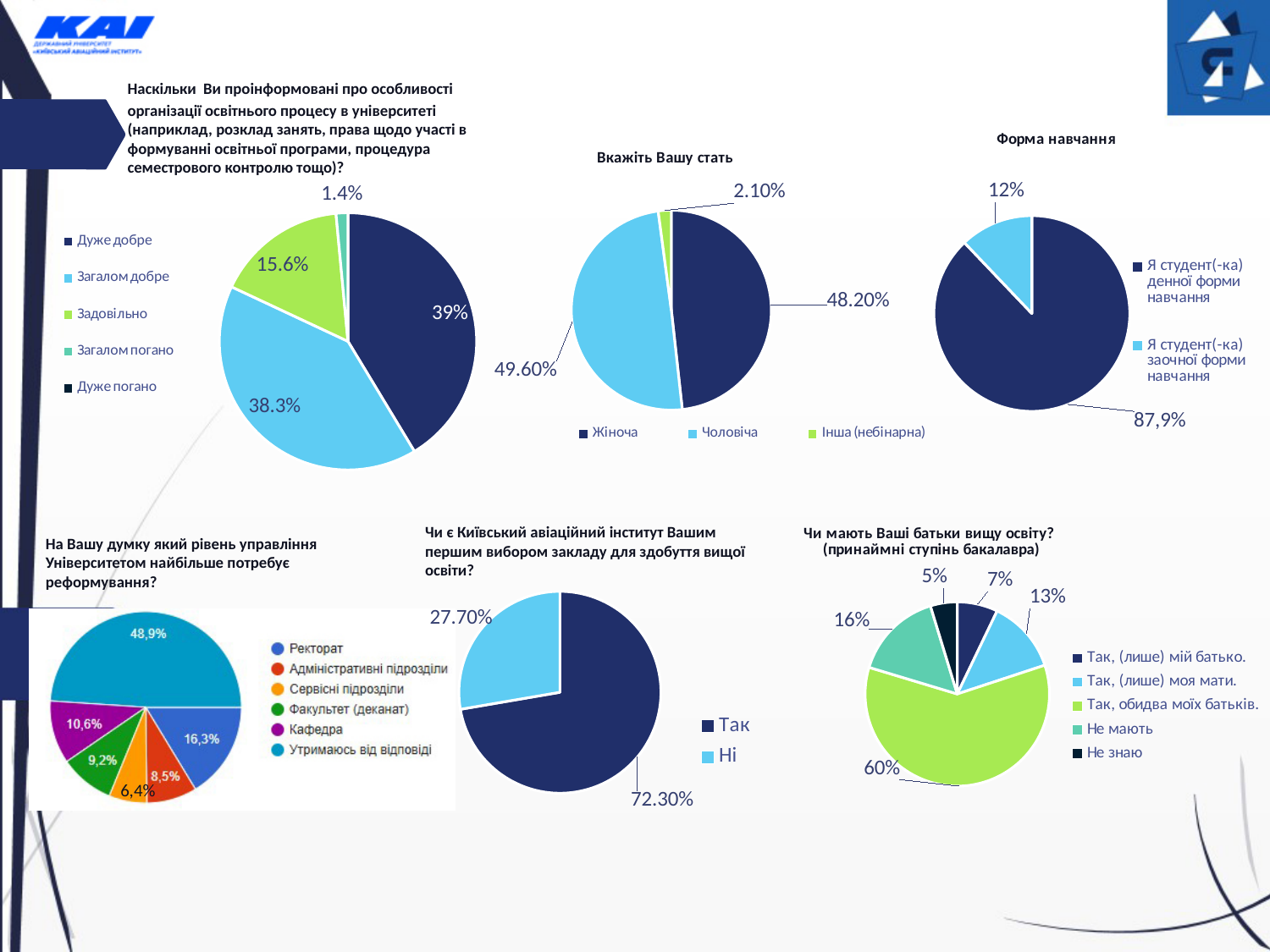
In the chart 'Чи мають Ваші батьки вищу освіту?', what percentage is shown for Не знаю? 5% What type of chart is used for 'Вкажіть Вашу стать'? Pie chart In the chart 'Чи мають Ваші батьки вищу освіту?', which category has the largest share? Так, обидва моїх батьків. In the chart 'Чи є Київський авіаційний інститут Вашим першим вибором закладу для здобуття вищої освіти?', what percentage answered Так? 72.30% In the 'Вкажіть Вашу стать' chart, what percentage is shown for Інша (небінарна)? 2.10% In the 'Форма навчання' chart, how many categories does the legend list? 2 In the 'Вкажіть Вашу стать' chart, what percentage is shown for Чоловіча? 49.60% In the chart 'На Вашу думку який рівень управління Університетом найбільше потребує реформування?', which category has the smallest share? Сервісні підрозділи In the chart 'Чи є Київський авіаційний інститут Вашим першим вибором закладу для здобуття вищої освіти?', what is the difference between the Так and Ні shares? 44.60% In the chart 'На Вашу думку який рівень управління Університетом найбільше потребує реформування?', what percentage is shown for Ректорат? 16,3% In the 'Форма навчання' chart, what share is shown for students of the full-time (денної) form of study? 87,9% In the top-left chart about how informed students are about the organisation of the educational process, what percentage is shown for the Загалом добре slice? 38.3%